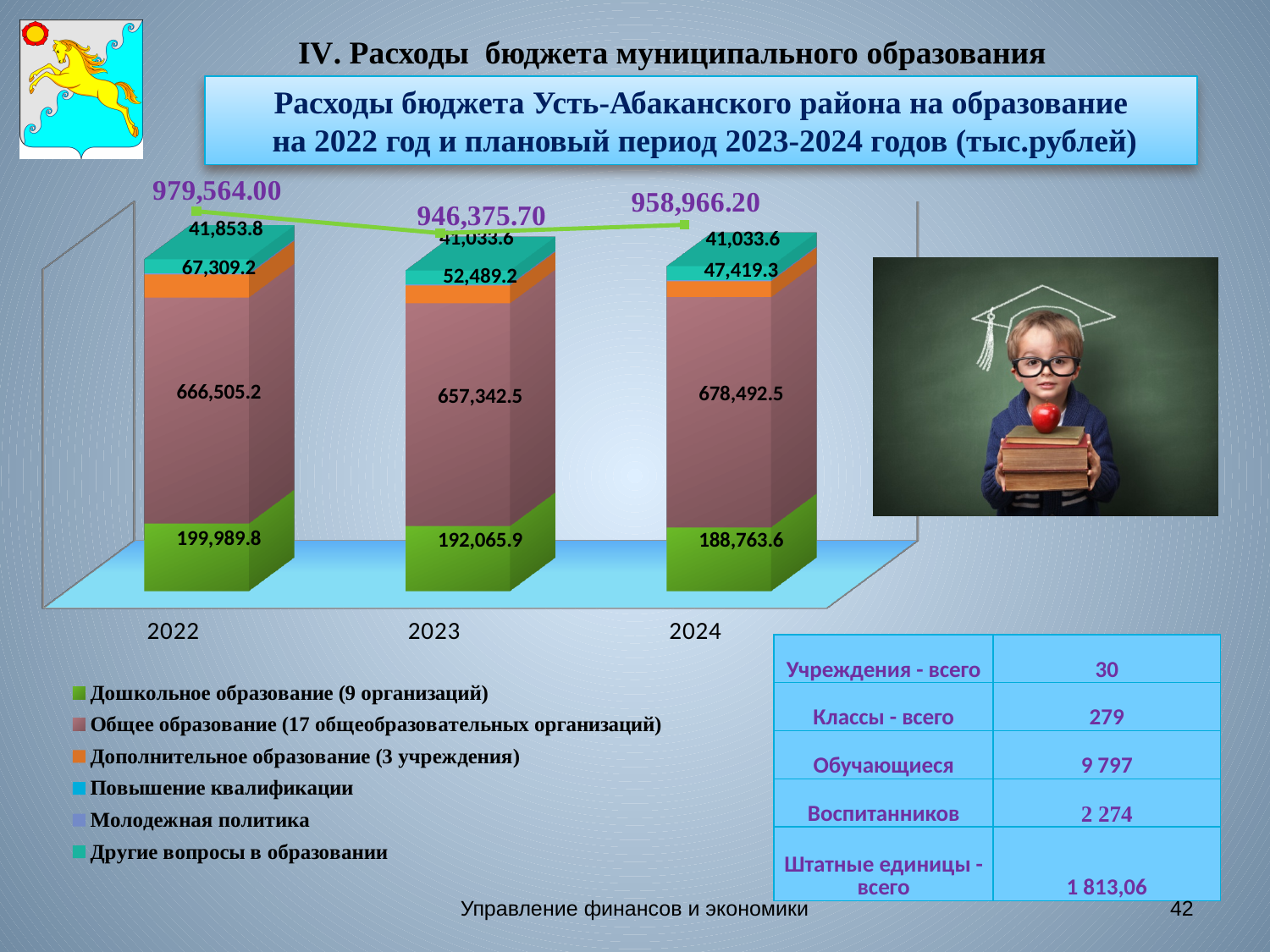
What is the difference between Дошкольное образование in 2022 and in 2023? 7,923.9 What is the total education expenditure shown for 2022? 979,564.00 What kind of chart is used to show the education expenditure? Stacked bar chart Which year has the highest total education expenditure? 2022 What is the value for Общее образование in 2024? 678,492.5 Which year has the lowest total education expenditure? 2023 Which is larger: Дошкольное образование in 2022 or in 2024? 2022 How many years are shown on the x axis of the chart? 3 How many series does the legend list? 6 What is the value for Дошкольное образование in 2022? 199,989.8 What is the value for Общее образование in 2023? 657,342.5 By how much does Общее образование in 2024 exceed Общее образование in 2023? 21,150.0